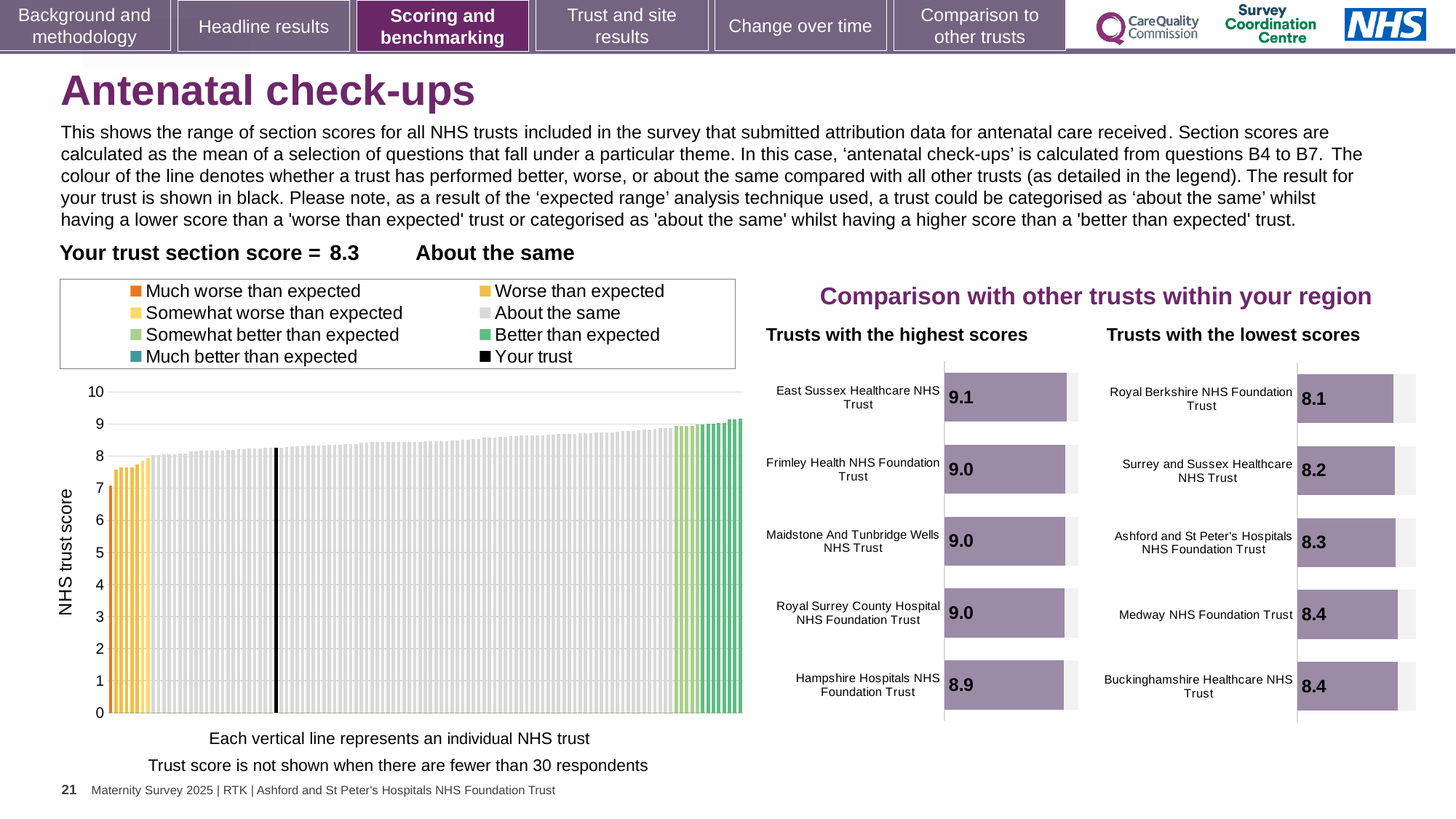
In the 'Trusts with the highest scores' chart, what is the difference between the scores of East Sussex Healthcare NHS Trust and Hampshire Hospitals NHS Foundation Trust? 0.2 In the 'Trusts with the lowest scores' chart, which trust has the lowest score? Royal Berkshire NHS Foundation Trust In the 'Trusts with the highest scores' chart, what is the score for East Sussex Healthcare NHS Trust? 9.1 In the NHS trust score chart on the left, what is the section score for your trust (the black bar)? 8.3 In the 'Trusts with the lowest scores' chart, what is the score for Medway NHS Foundation Trust? 8.4 How many entries does the legend of the NHS trust score chart on the left list? 8 In the 'Trusts with the lowest scores' chart, which has the higher score: Surrey and Sussex Healthcare NHS Trust or Ashford and St Peter's Hospitals NHS Foundation Trust? Ashford and St Peter's Hospitals NHS Foundation Trust In the NHS trust score chart on the left, is the value of the rightmost bar greater or less than 9? greater In the 'Trusts with the highest scores' chart, which trust has the highest score? East Sussex Healthcare NHS Trust In the NHS trust score chart on the left, do the bar values rise or fall from left to right? rise How many trusts are listed in the 'Trusts with the highest scores' chart? 5 In the 'Trusts with the lowest scores' chart, what is the difference between the scores of Buckinghamshire Healthcare NHS Trust and Royal Berkshire NHS Foundation Trust? 0.3